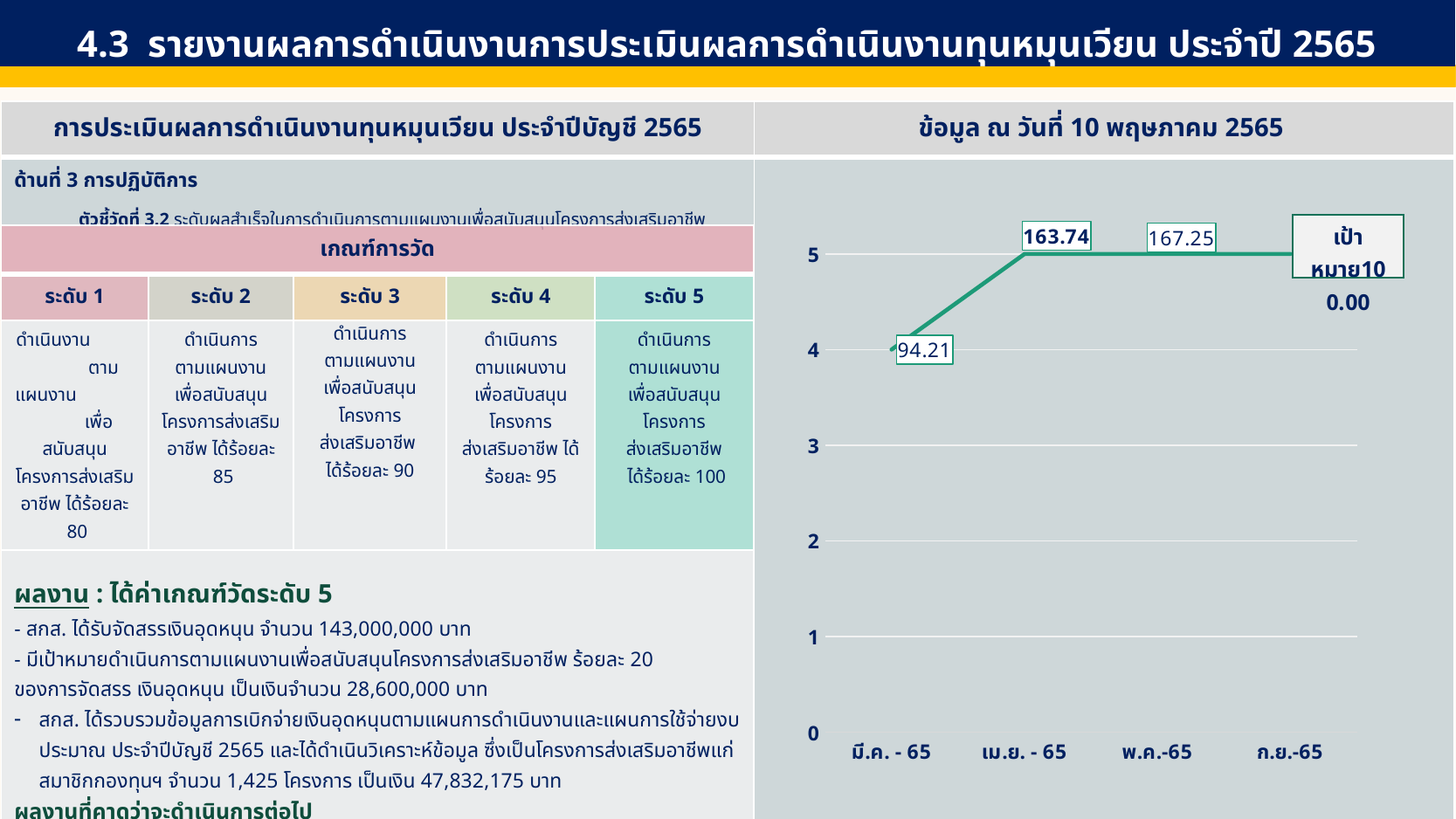
What kind of chart is shown on the right side of the slide? line chart What is the title shown above the chart? ข้อมูล ณ วันที่ 10 พฤษภาคม 2565 Which has the larger data label, มี.ค. - 65 or เม.ย. - 65? เม.ย. - 65 What is the difference between the data labels for พ.ค.-65 and เม.ย. - 65? 3.51 What is the data label for มี.ค. - 65 in the chart? 94.21 What is the data label for เม.ย. - 65 in the chart? 163.74 What is the data label for พ.ค.-65 in the chart? 167.25 Which category has the highest data label in the chart? พ.ค.-65 Is the plotted level for มี.ค. - 65 greater or less than 5? less How many categories are shown on the x axis of the chart? 4